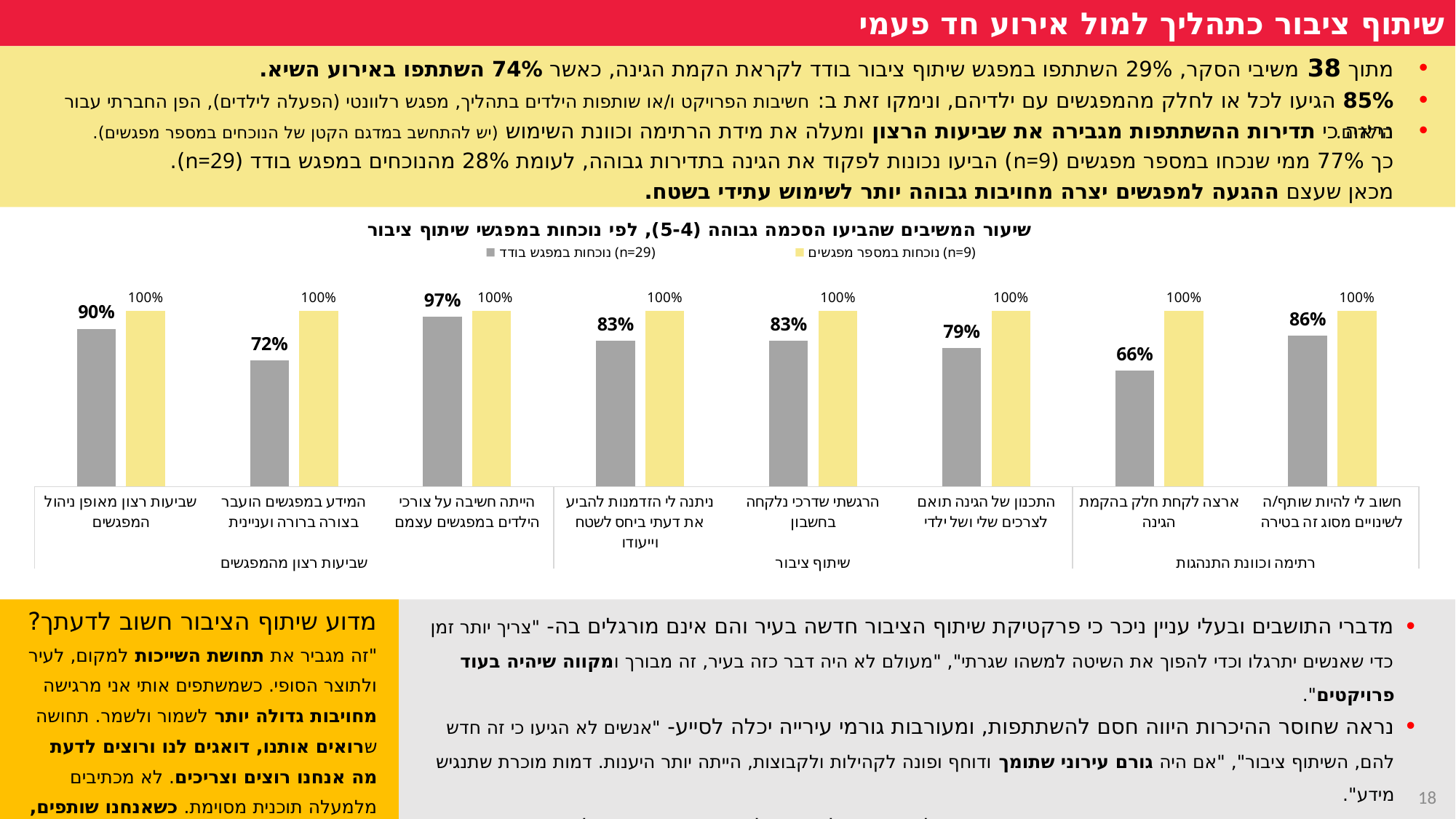
Which category has the lowest value for the "נוכחות במפגש בודד (n=29)" series? ארצה לקחת חלק בהקמת הגינה What is the value for "נוכחות במפגש בודד (n=29)" for the category "ארצה לקחת חלק בהקמת הגינה"? 66% For the "נוכחות במפגש בודד (n=29)" series, which is larger: "שביעות רצון מאופן ניהול המפגשים" or "חשוב לי להיות שותף/ה לשינויים מסוג זה בטירה"? שביעות רצון מאופן ניהול המפגשים How many categories are shown on the x axis of the chart? 8 Which series is shown in yellow in the chart legend? נוכחות במספר מפגשים (n=9) What kind of chart is shown on the slide? Bar chart What is the difference between the two series for the category "המידע במפגשים הועבר בצורה ברורה ועניינית"? 28% How many series does the chart legend list? 2 What is the value for "נוכחות במפגש בודד (n=29)" for the category "הרגשתי שדרכי נלקחה בחשבון"? 83% What is the value for "נוכחות במספר מפגשים (n=9)" for the category "התכנון של הגינה תואם לצרכים שלי ושל ילדי"? 100% Which category has the highest value for the "נוכחות במפגש בודד (n=29)" series? הייתה חשיבה על צורכי הילדים במפגשים עצמם What is the value for "נוכחות במפגש בודד (n=29)" for the category "הייתה חשיבה על צורכי הילדים במפגשים עצמם"? 97%